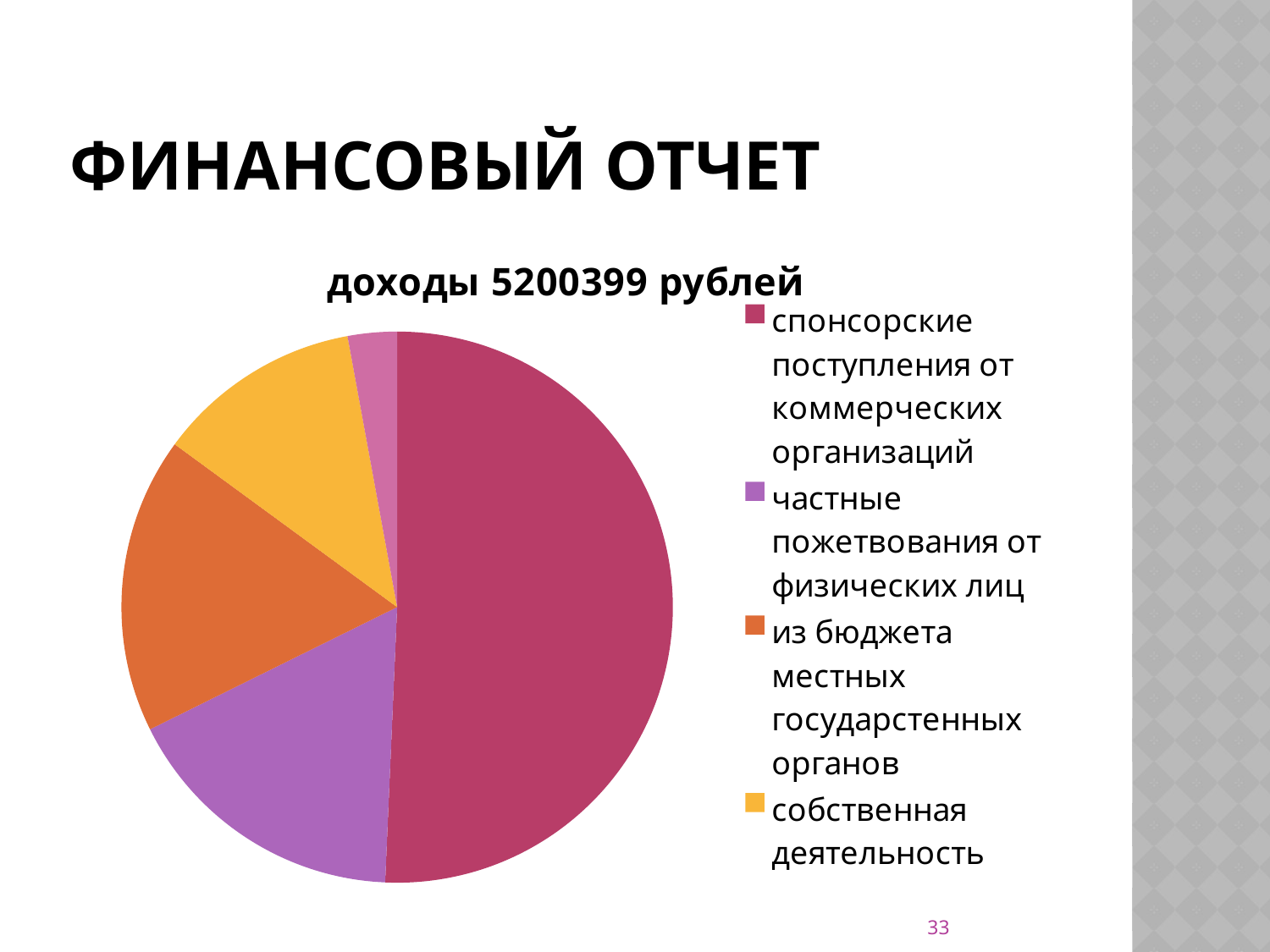
Which slice is larger: собственная деятельность or из бюджета местных государстенных органов? из бюджета местных государстенных органов Which slice is larger: частные пожетвования от физических лиц or собственная деятельность? частные пожетвования от физических лиц What colour is the slice for собственная деятельность? yellow How many entries does the legend list? 4 What kind of chart is shown on the slide? pie chart How many slices does the pie chart have? 5 Which category has the largest slice of the pie? спонсорские поступления от коммерческих организаций What is the title of the pie chart? доходы 5200399 рублей Of the categories listed in the legend, which has the smallest slice? собственная деятельность Which slice is larger: спонсорские поступления от коммерческих организаций or частные пожетвования от физических лиц? спонсорские поступления от коммерческих организаций